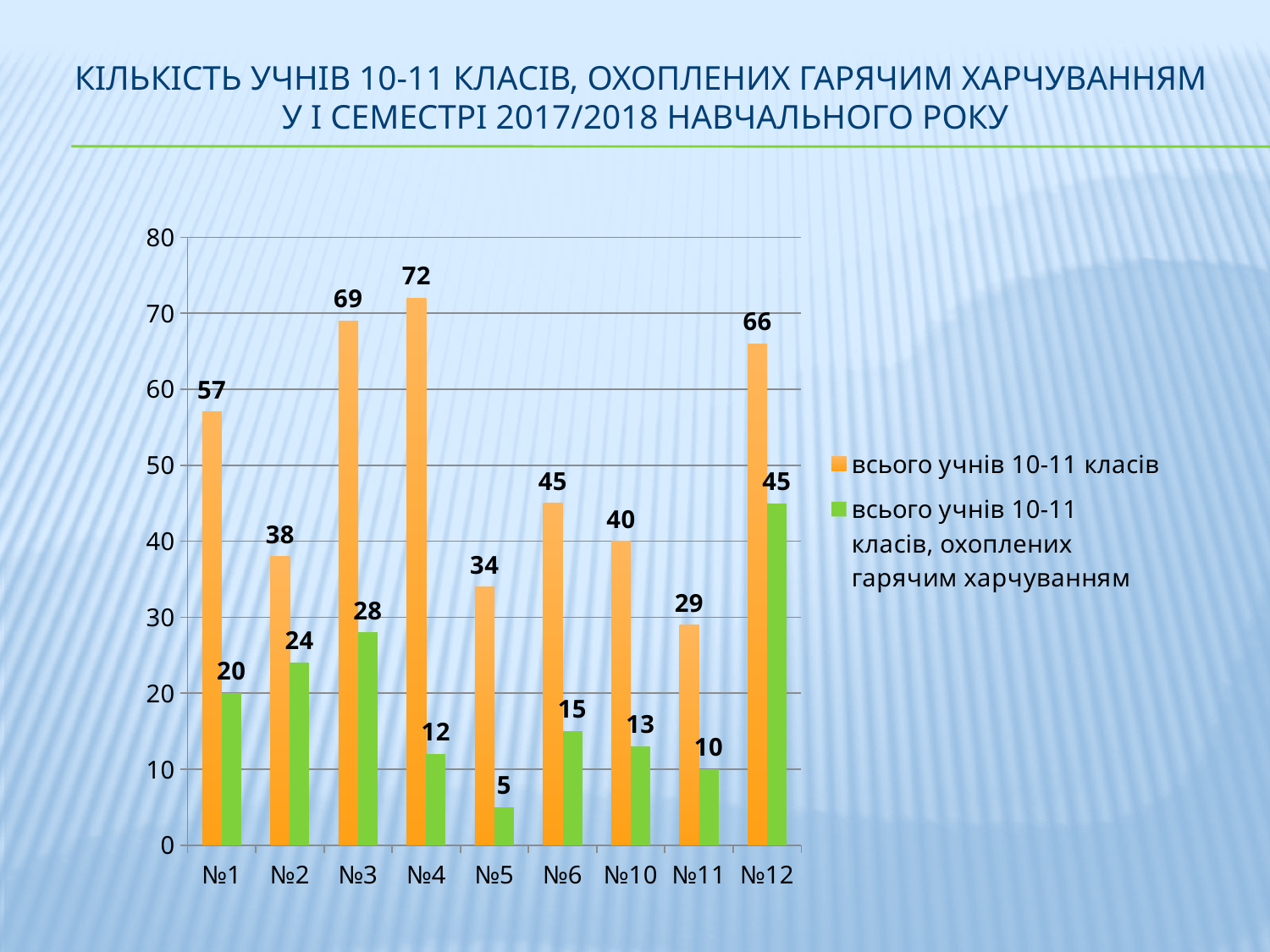
Which category has the highest value for 'всього учнів 10-11 класів'? №4 How many categories (schools) are shown on the x axis? 9 Is the value of 'всього учнів 10-11 класів' for №11 greater or less than 30? less Which is larger: 'всього учнів 10-11 класів' for №3 or for №12? №3 Which category has the highest value for 'всього учнів 10-11 класів, охоплених гарячим харчуванням'? №12 What is the value of 'всього учнів 10-11 класів, охоплених гарячим харчуванням' for №5? 5 How many series does the legend list? 2 What is the difference between 'всього учнів 10-11 класів' and 'всього учнів 10-11 класів, охоплених гарячим харчуванням' for №12? 21 What type of chart is shown on the slide? bar chart What is the value of 'всього учнів 10-11 класів' for №4? 72 Which category has the lowest value for 'всього учнів 10-11 класів, охоплених гарячим харчуванням'? №5 What colour are the bars for 'всього учнів 10-11 класів, охоплених гарячим харчуванням'? green